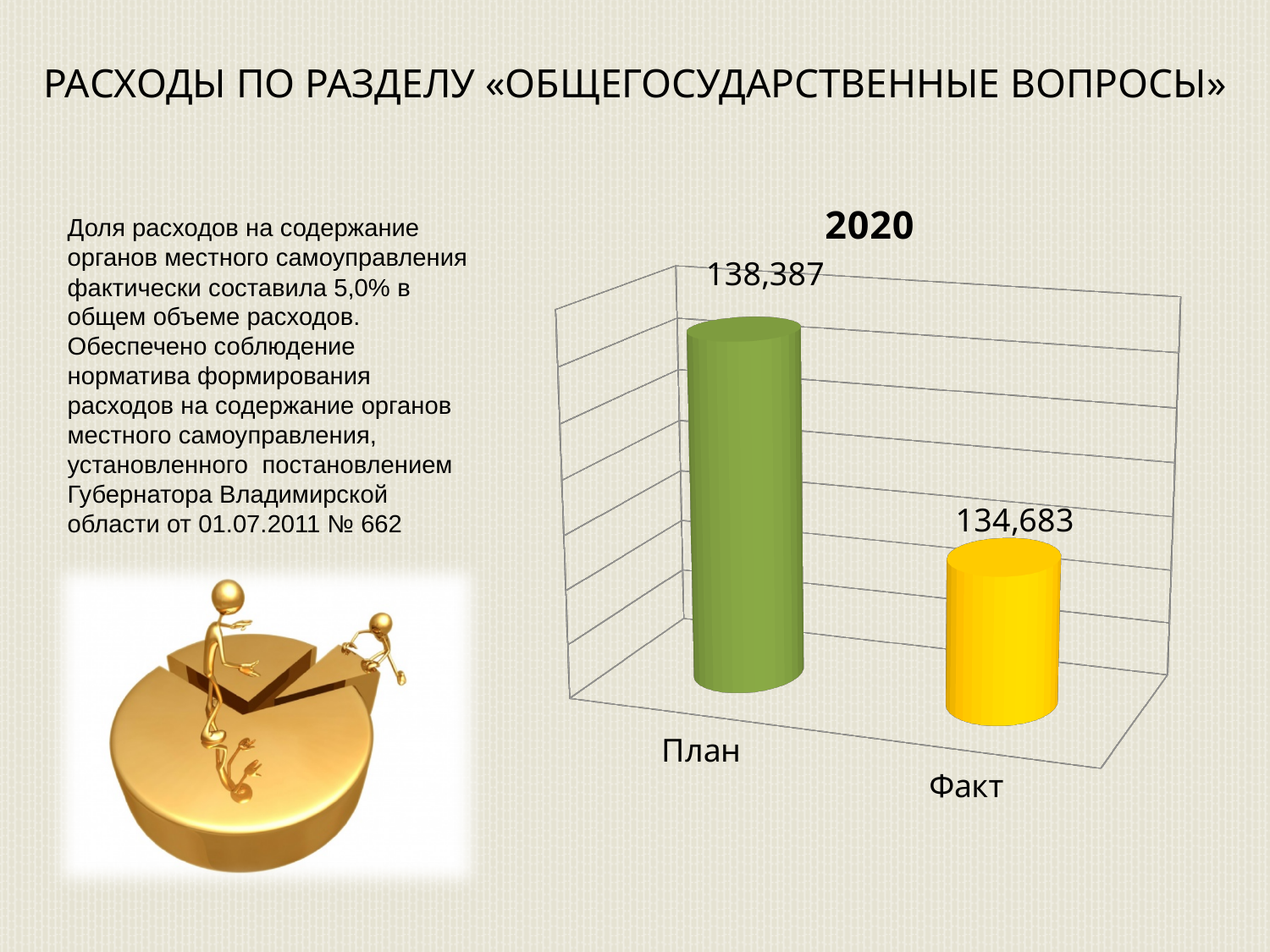
What kind of chart is shown on the slide? Bar chart What colour is the Факт bar? Yellow Do the values rise or fall from План to Факт? Fall Which category has the lowest value in the chart? Факт What is the value for Факт in the 2020 chart? 134,683 What is the value for План in the 2020 chart? 138,387 How many categories are shown in the chart? 2 Which category has the highest value in the chart? План What is the difference between the План and Факт values? 3,704 Which category has the higher value, План or Факт? План What is the title of the chart? 2020